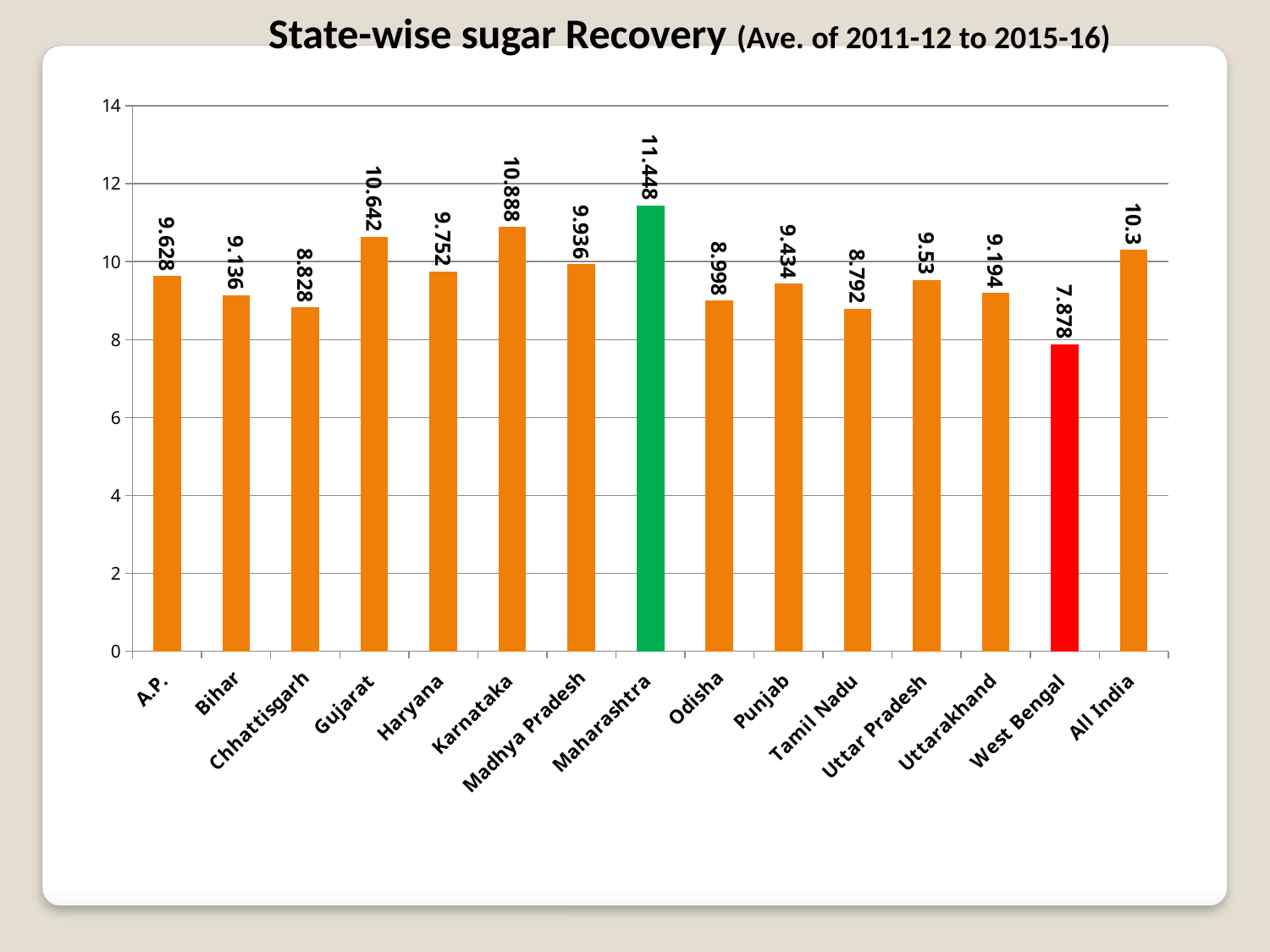
Which state has the highest sugar recovery? Maharashtra Which state has the lowest sugar recovery? West Bengal Is the value for Odisha greater or less than 10? less What is the difference between the sugar recovery of Karnataka and Gujarat? 0.246 What is the sugar recovery value for All India? 10.3 What is the sugar recovery value for Tamil Nadu? 8.792 What is the sugar recovery value for Maharashtra? 11.448 How many categories are shown on the x axis? 15 Which has a higher sugar recovery, Gujarat or Haryana? Gujarat Which bar is coloured red? West Bengal What kind of chart is shown on the slide? Bar chart What is the difference between the sugar recovery of Maharashtra and West Bengal? 3.57